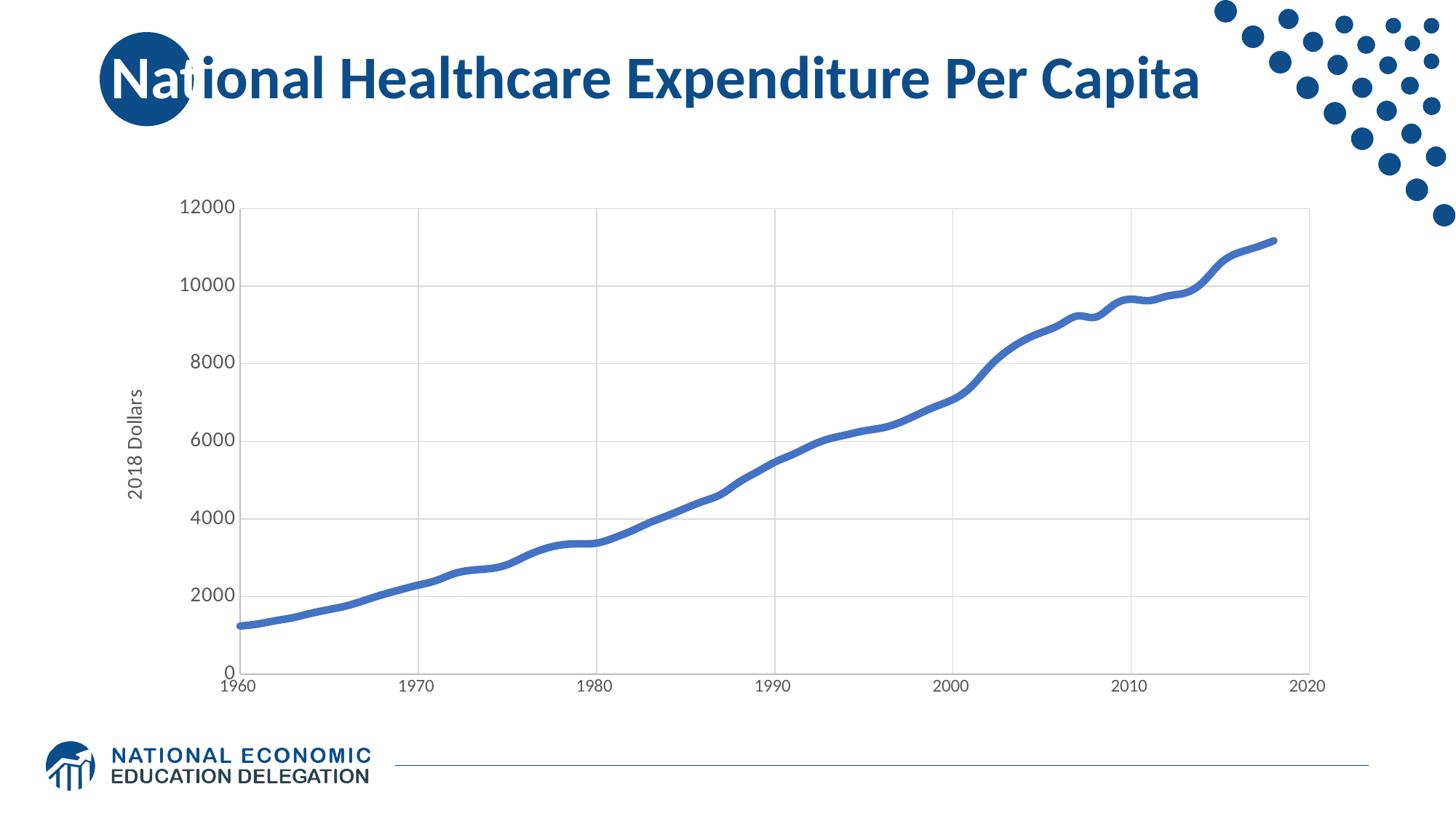
In which year shown on the x axis is the value lowest? 1960 Is the value at the end of the line (around 2018) greater or less than 10000? greater Is the value for 1960 greater or less than 2000? less Is the value for 1980 greater or less than 4000? less What kind of chart is shown on the slide? line chart What is the title of the chart? National Healthcare Expenditure Per Capita Which of the two values is larger, the value for 1970 or the value for 2000? 2000 Do the values rise or fall from 1960 to 2018 along the x axis? rise What is the label on the vertical axis of the chart? 2018 Dollars